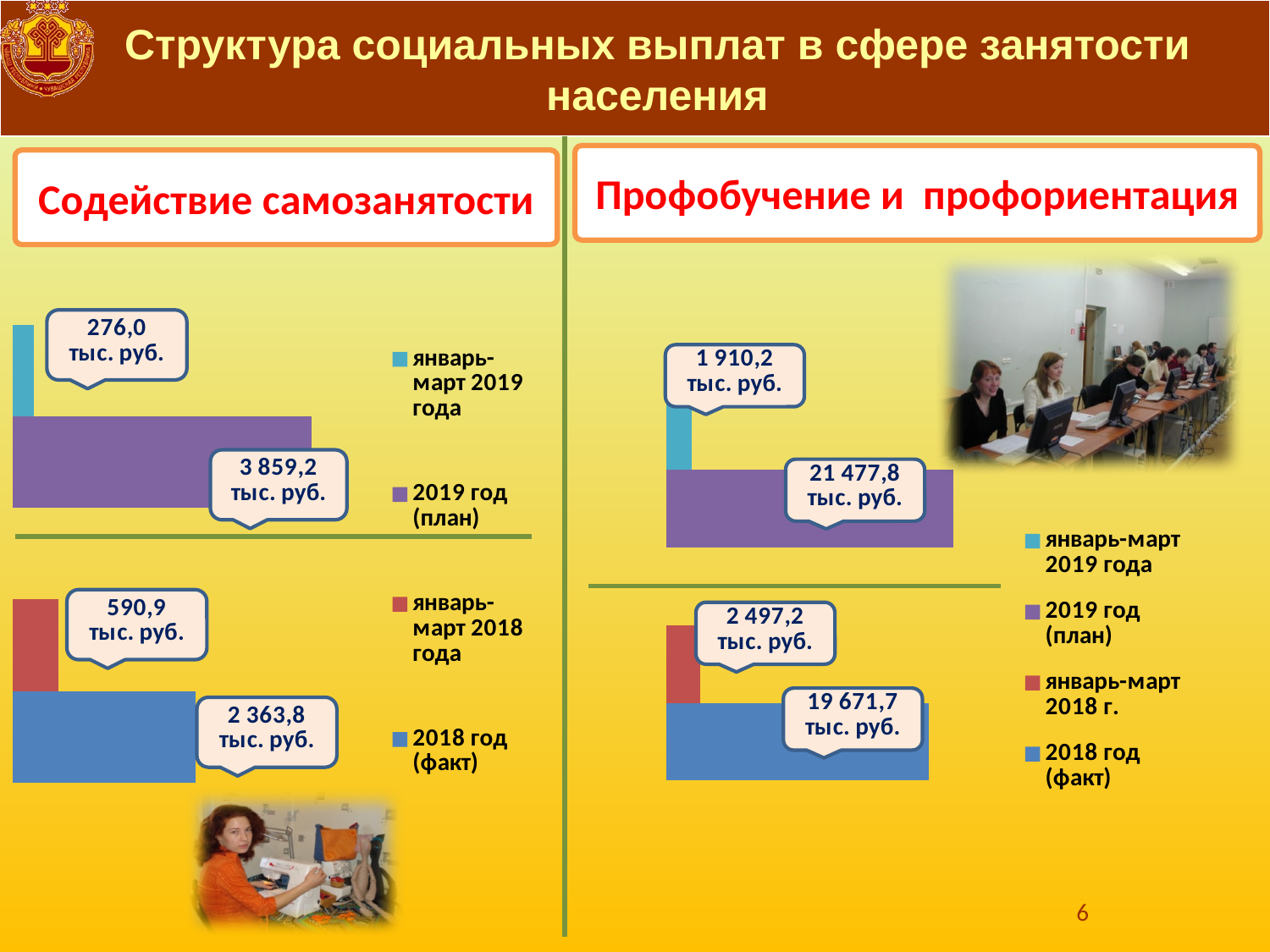
In the 'Содействие самозанятости' chart, what is the value for 2019 год (план)? 3 859,2 тыс. руб. In the 'Профобучение и профориентация' chart, what is the value for 2019 год (план)? 21 477,8 тыс. руб. How many entries does the legend of the 'Профобучение и профориентация' chart list? 4 In the 'Профобучение и профориентация' chart, what is the difference between январь-март 2018 г. and январь-март 2019 года? 587,0 тыс. руб. In the 'Содействие самозанятости' chart, what is the difference between 2019 год (план) and 2018 год (факт)? 1 495,4 тыс. руб. In the 'Содействие самозанятости' chart, which category has the lowest value? январь-март 2019 года In the 'Профобучение и профориентация' chart, which category has the highest value? 2019 год (план) In the 'Содействие самозанятости' chart, what is the value for 2018 год (факт)? 2 363,8 тыс. руб. In the 'Содействие самозанятости' chart, which is larger: январь-март 2018 года or январь-март 2019 года? январь-март 2018 года What kind of chart is used in the 'Профобучение и профориентация' section? Bar chart In the 'Содействие самозанятости' chart, what is the value for январь-март 2019 года? 276,0 тыс. руб. In the 'Профобучение и профориентация' chart, what is the value for январь-март 2019 года? 1 910,2 тыс. руб.